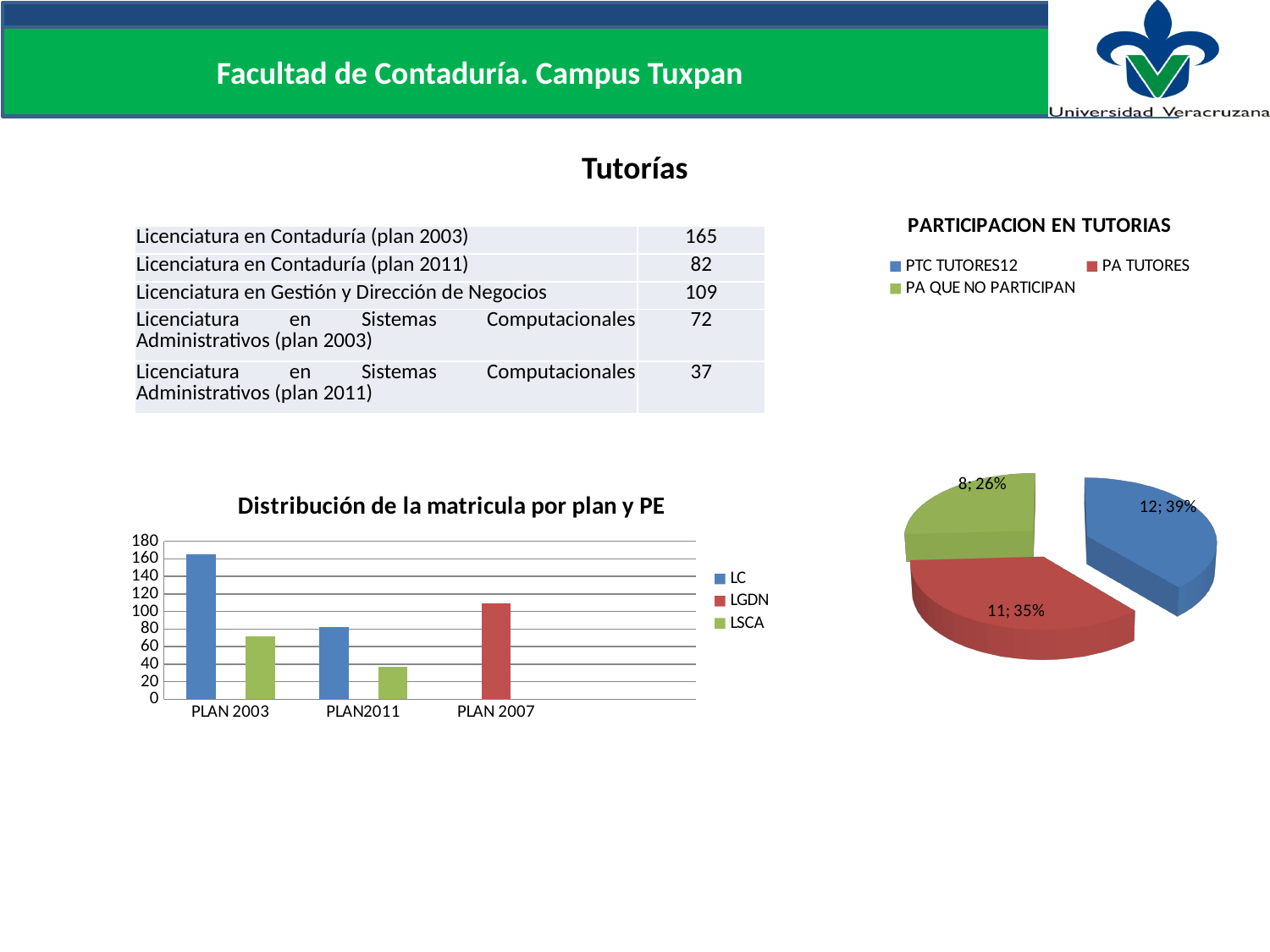
What kind of chart is 'Distribución de la matricula por plan y PE'? bar chart In the PARTICIPACION EN TUTORIAS pie chart, which category has the smallest slice? PA QUE NO PARTICIPAN In the PARTICIPACION EN TUTORIAS pie chart, what is the difference between the values for PTC TUTORES12 and PA QUE NO PARTICIPAN? 4 In the 'Distribución de la matricula por plan y PE' chart, is the value for LSCA in PLAN2011 greater or less than 60? less In the PARTICIPACION EN TUTORIAS pie chart, what share does PA QUE NO PARTICIPAN have? 26% In the PARTICIPACION EN TUTORIAS pie chart, what share does PTC TUTORES12 have? 39% In the PARTICIPACION EN TUTORIAS pie chart, which category has the largest slice? PTC TUTORES12 In the 'Distribución de la matricula por plan y PE' chart, which is larger: LC in PLAN 2003 or LGDN in PLAN 2007? LC in PLAN 2003 In the PARTICIPACION EN TUTORIAS pie chart, what is the value shown for PA TUTORES? 11 How many slices does the PARTICIPACION EN TUTORIAS pie chart have? 3 In the 'Distribución de la matricula por plan y PE' chart, is the value for LC in PLAN 2003 greater or less than 140? greater How many series does the legend of the 'Distribución de la matricula por plan y PE' chart list? 3